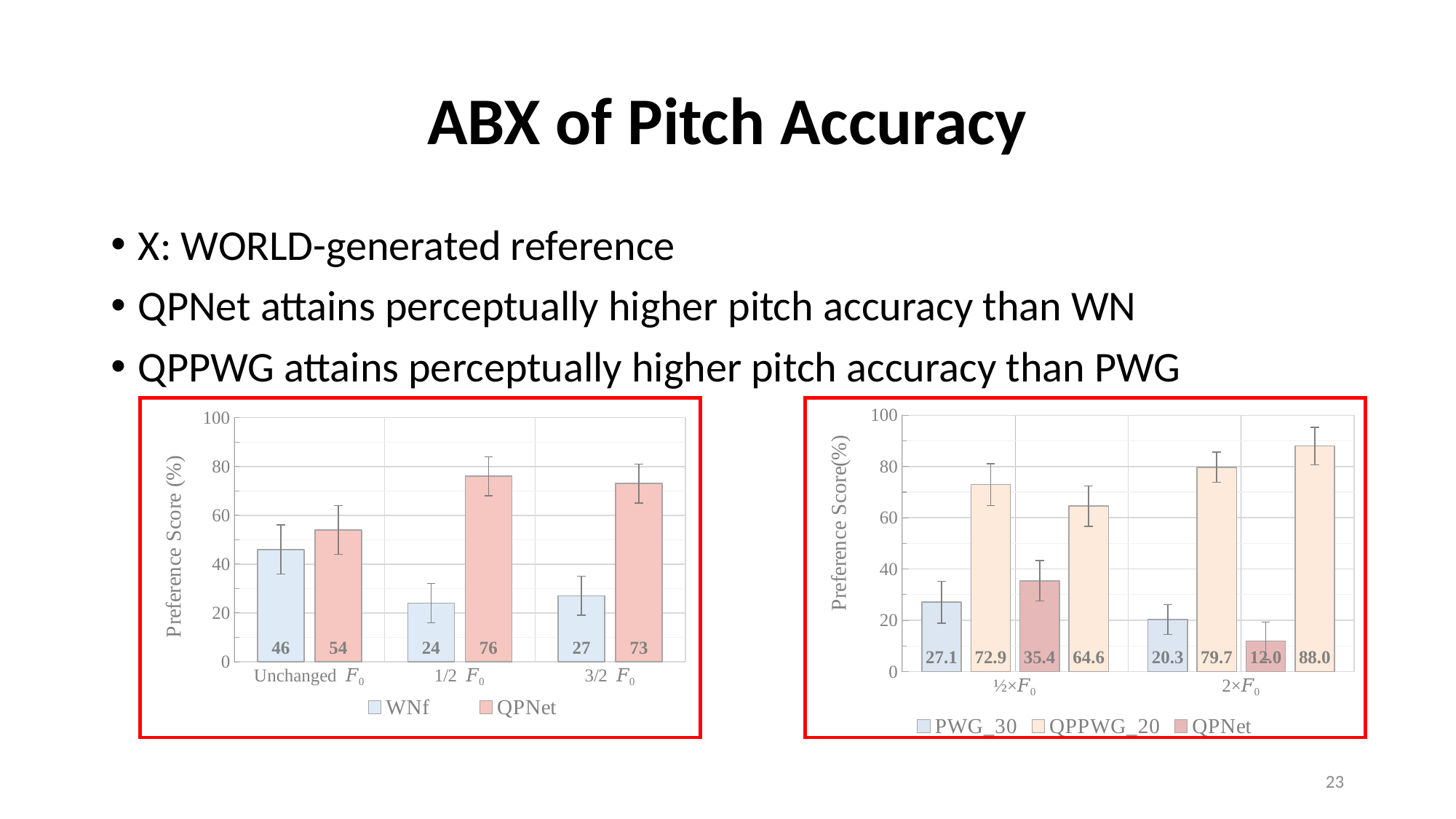
In the left chart, which category has the highest QPNet preference score? 1/2 F0 In the left chart, what is the difference between the QPNet and WNf scores for 3/2 F0? 46 In the right chart, how many series does the legend list? 3 In the left chart, what is the QPNet preference score for 1/2 F0? 76 In the right chart, what is the difference between the PWG_30 scores for ½×F0 and 2×F0? 6.8 In the right chart, what is the PWG_30 preference score for ½×F0? 27.1 In the left chart, which is larger for Unchanged F0: the WNf score or the QPNet score? QPNet In the right chart, what is the QPNet preference score for 2×F0? 12.0 In the left chart, how many series does the legend list? 2 What kind of chart is the right chart? Bar chart In the left chart, which category has the lowest WNf preference score? 1/2 F0 In the left chart, what is the WNf preference score for Unchanged F0? 46